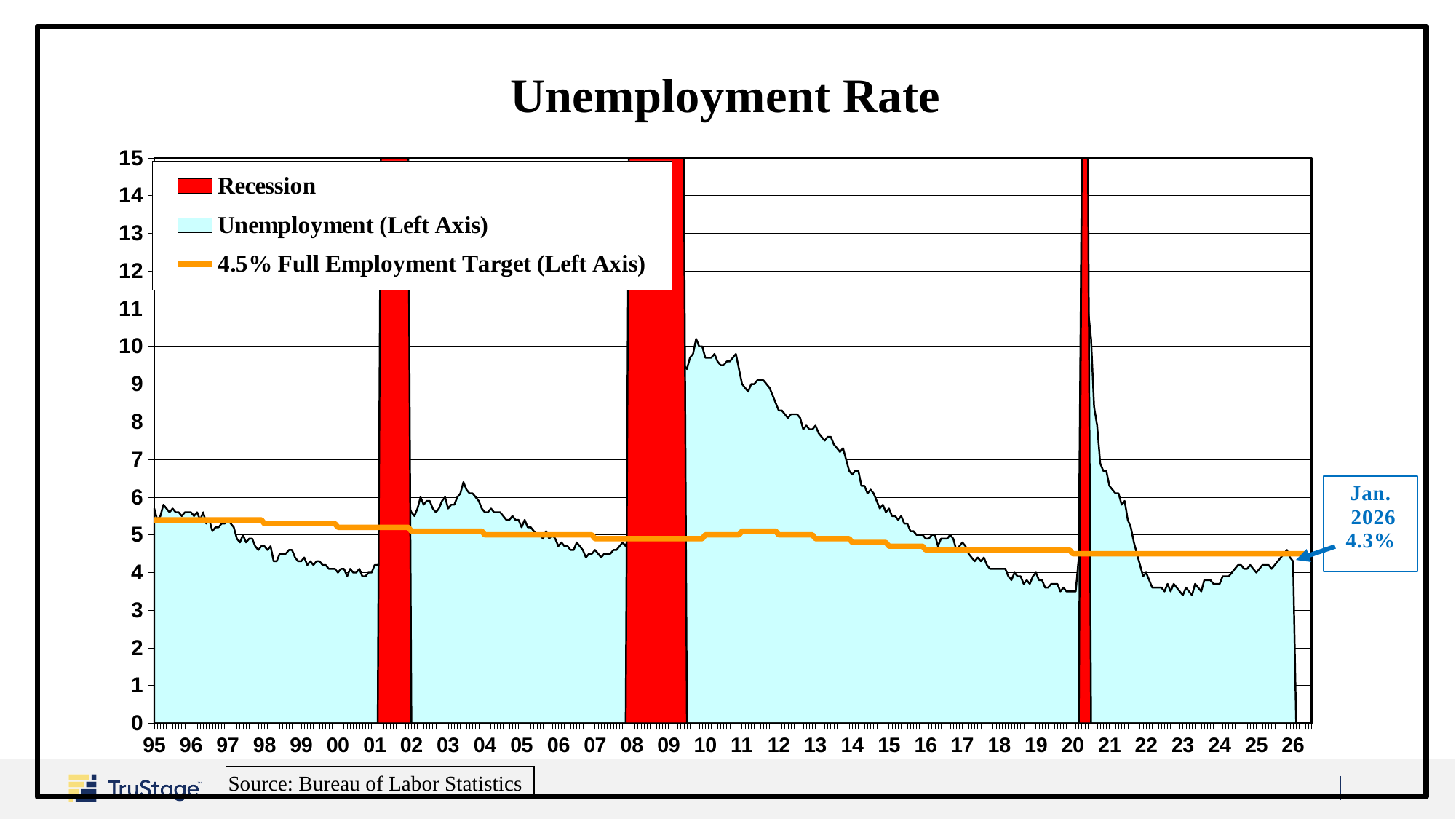
What is the full employment target value shown in the legend? 4.5% Which is higher, the unemployment rate in 2010 or in 2000? 2010 How many recession periods are shaded on the chart? 3 Is the unemployment rate in 2000 greater or less than 5? less Is the unemployment rate in 2023 greater or less than 4? less What kind of chart is shown on the slide? Combination area and line chart What is the unemployment rate shown for Jan. 2026? 4.3% How many entries does the chart's legend list? 3 Is the unemployment rate in 2012 greater or less than 7? greater Does the unemployment rate rise or fall from 2010 to 2019? Fall What is the title of the chart? Unemployment Rate